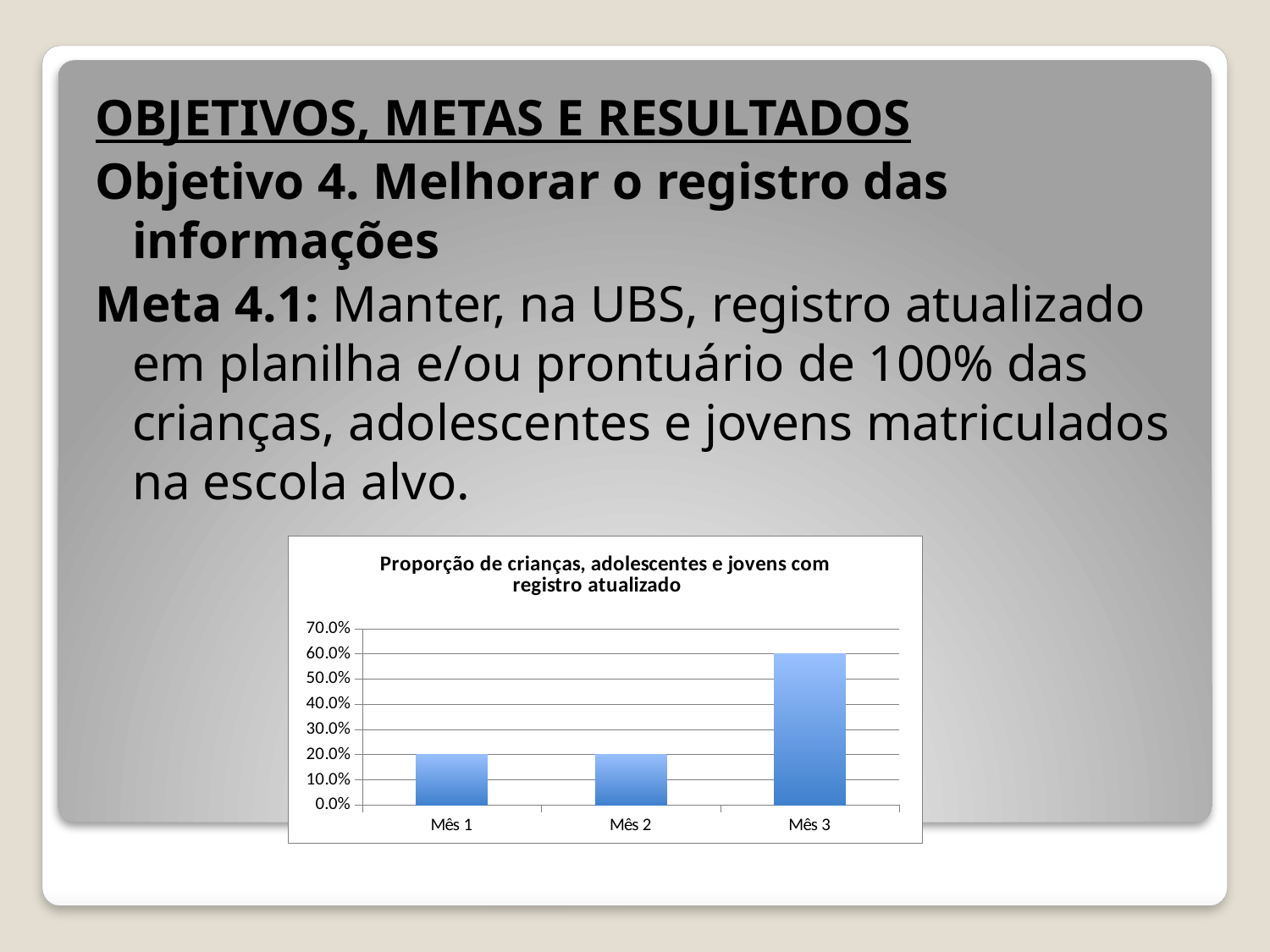
What is the value for Mês 1? 20.0% What is the title of the chart? Proporção de crianças, adolescentes e jovens com registro atualizado Which month has the highest value? Mês 3 What type of chart is shown on the slide? bar chart Which is larger, the value for Mês 2 or the value for Mês 3? Mês 3 What is the value for Mês 3? 60.0% What is the difference between the values for Mês 3 and Mês 1? 40.0% What is the value for Mês 2? 20.0% How many categories are shown on the x axis of the chart? 3 Is the value for Mês 3 greater or less than 50.0%? greater Is the value for Mês 1 greater or less than 30.0%? less Do the values rise or fall from Mês 2 to Mês 3? rise